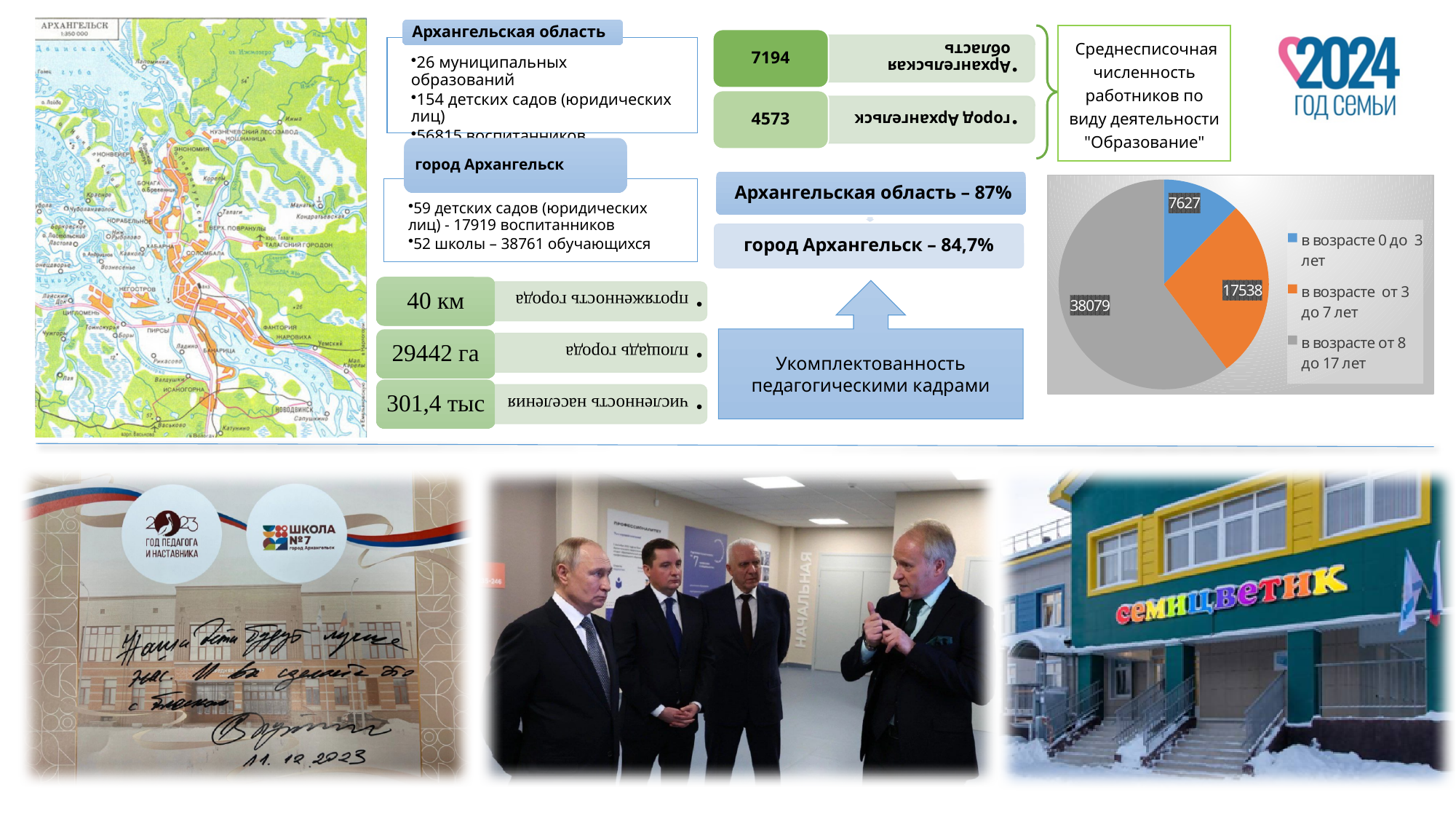
What is the difference between the values for 'в возрасте от 8 до 17 лет' and 'в возрасте от 3 до 7 лет' in the pie chart? 20541 What is the total of all three slices in the pie chart? 63244 Which age group has the smallest slice in the pie chart? в возрасте 0 до 3 лет Which is larger in the pie chart: the value for 'в возрасте от 3 до 7 лет' or for 'в возрасте 0 до 3 лет'? в возрасте от 3 до 7 лет What colour is the slice for 'в возрасте от 3 до 7 лет' in the pie chart? orange How many entries does the pie chart's legend list? 3 What is the value for the slice 'в возрасте от 8 до 17 лет' in the pie chart? 38079 What is the value for the slice 'в возрасте 0 до 3 лет' in the pie chart? 7627 What kind of chart is shown on the slide? pie chart How many slices does the pie chart have? 3 What is the value for the slice 'в возрасте от 3 до 7 лет' in the pie chart? 17538 Which age group has the largest slice in the pie chart? в возрасте от 8 до 17 лет